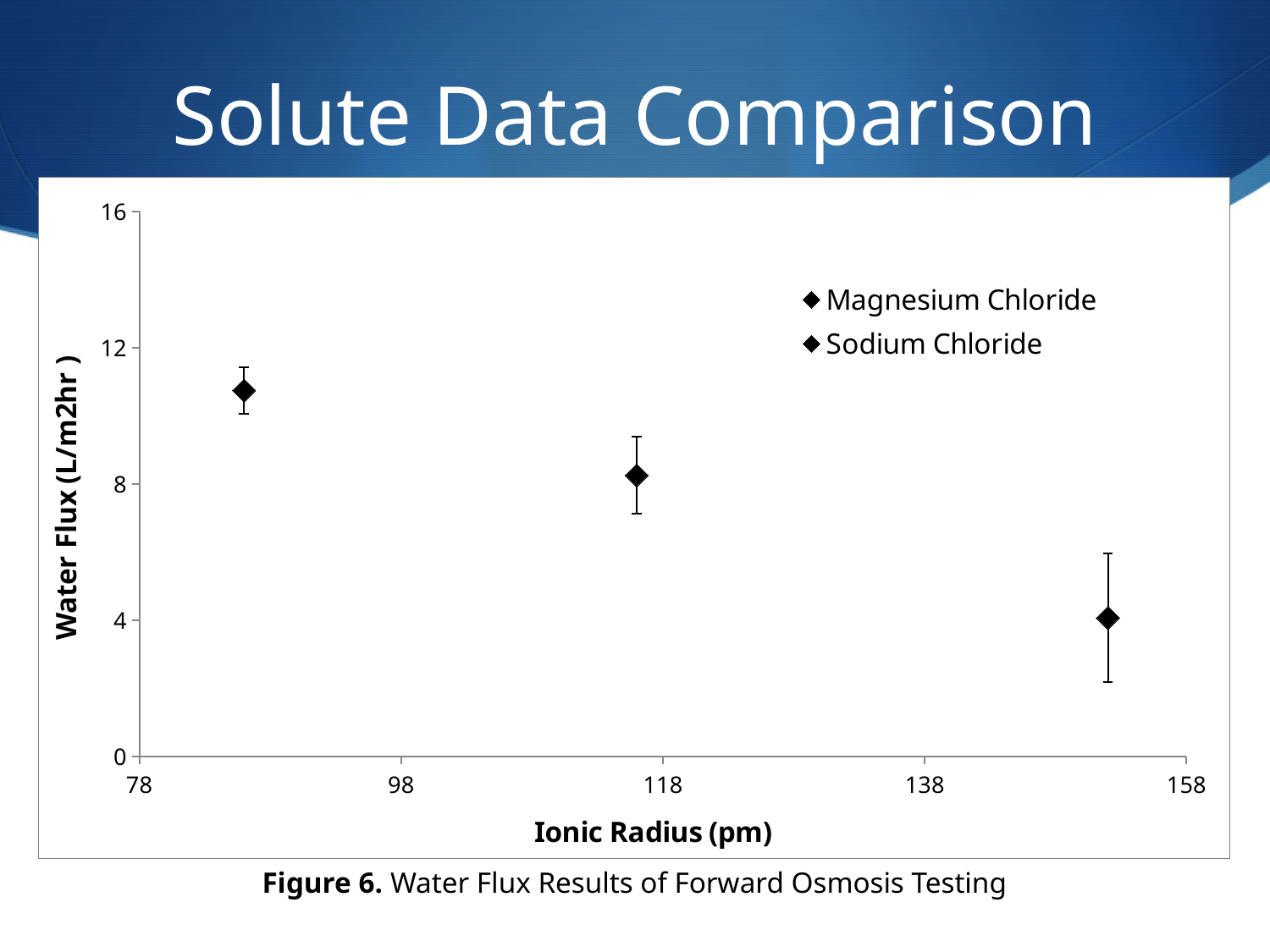
What kind of chart is shown on the slide? scatter chart Which plotted point has the highest water flux: the leftmost, middle, or rightmost? leftmost What is the title of the x axis? Ionic Radius (pm) How many series does the legend list? 2 Is the water flux value for the middle point (near 116 pm) greater or less than 12? less Which plotted point has the lowest water flux: the leftmost, middle, or rightmost? rightmost Is the water flux value for the rightmost point (near 152 pm) greater or less than 8? less How many data points are plotted on the chart? 3 What are the two series named in the legend? Magnesium Chloride and Sodium Chloride Is the water flux value for the leftmost point (near 86 pm) greater or less than 8? greater Do the water flux values rise or fall as ionic radius increases along the x axis? fall